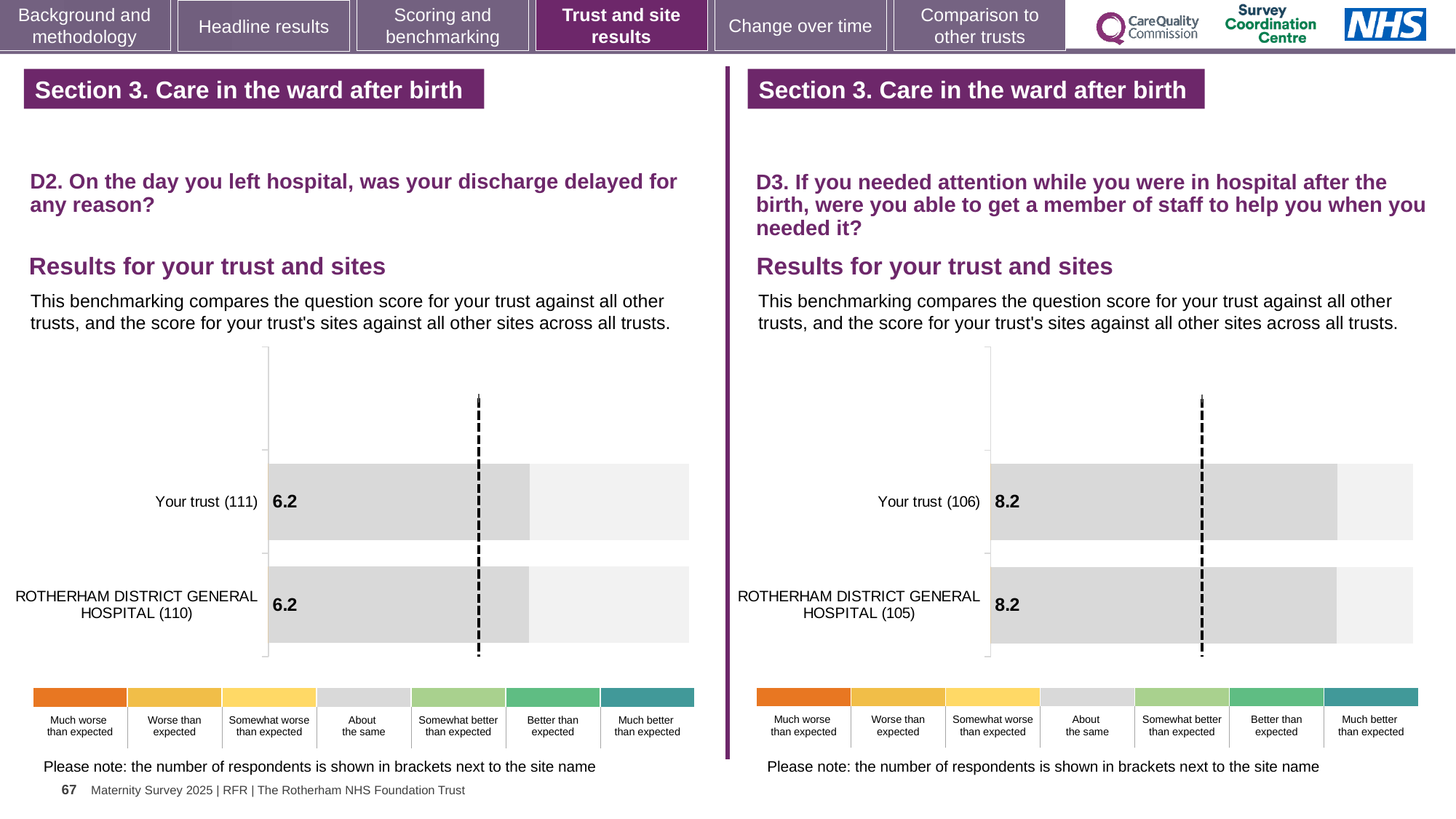
On the D2 chart (left), how many respondents are shown in brackets next to Your trust? 111 How many bars are plotted on the D3 chart (right)? 2 On the D2 chart (left), what is the score for Your trust? 6.2 On the D2 chart (left), what is the score for Rotherham District General Hospital? 6.2 How many bars are plotted on the D2 chart (left)? 2 Which chart shows the higher score for Your trust, the D2 chart (left) or the D3 chart (right)? D3 chart (right) On the D3 chart (right), what is the score for Rotherham District General Hospital? 8.2 On the D3 chart (right), what is the difference between the Your trust score and the Rotherham District General Hospital score? 0 What type of chart is used on the D3 chart (right)? Bar chart On the D3 chart (right), what is the score for Your trust? 8.2 On the D2 chart (left), what is the difference between the Your trust score and the Rotherham District General Hospital score? 0 How many categories does the colour key below the D3 chart (right) list? 7